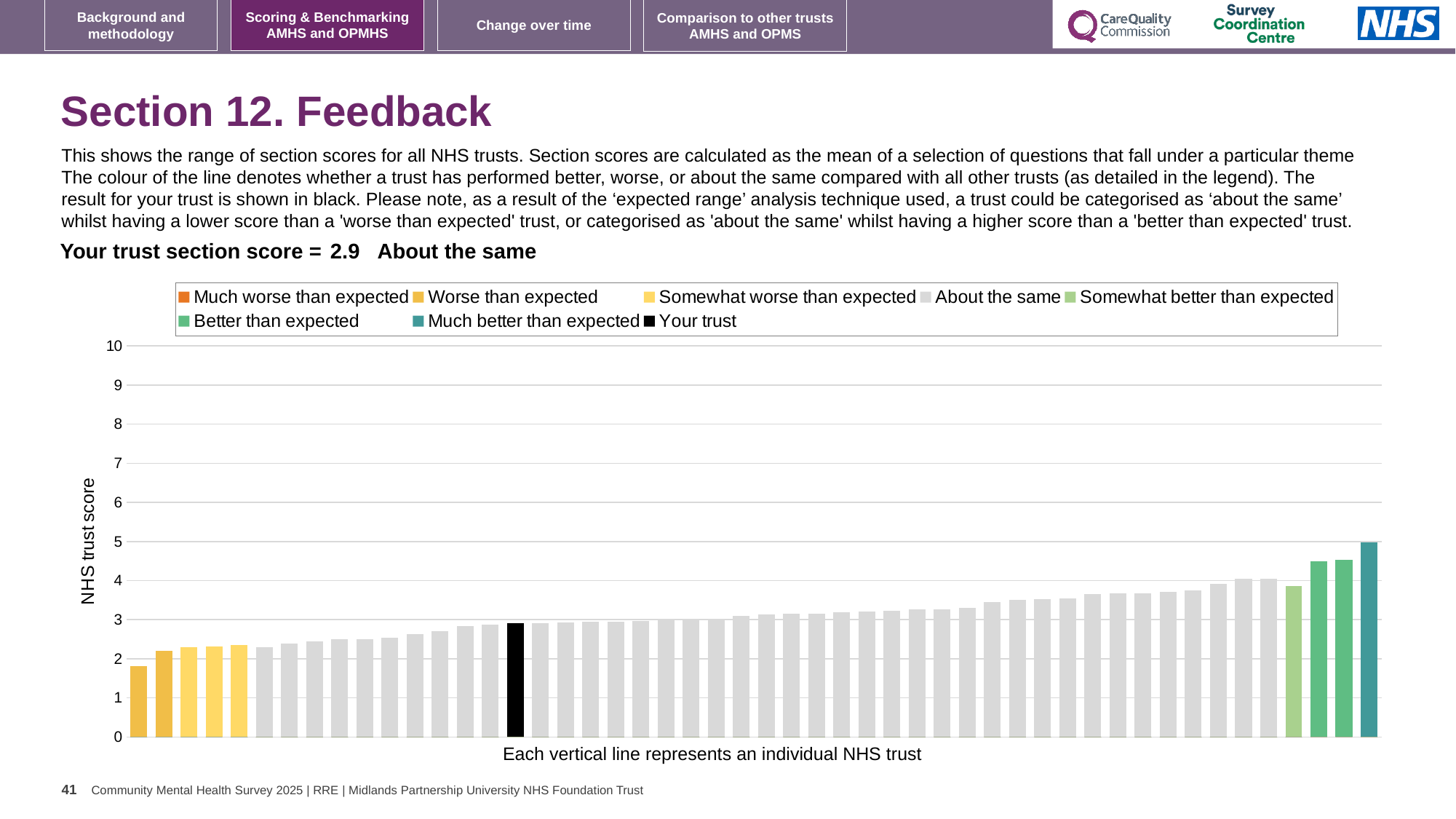
Is the value of the rightmost bar greater or less than 4? greater Do the bar values rise or fall from left to right across the chart? Rise Is the value of the black bar (your trust) greater or less than 3? less What is the highest value shown on the vertical axis? 10 What is the title of the vertical axis? NHS trust score What kind of chart is shown on the slide? Bar chart Is the value of the shortest bar in the chart greater or less than 2? less What colour is the bar representing your trust? Black How many entries does the chart legend list? 8 What is the section score for your trust shown on the slide? 2.9 Which category is your trust placed in for this section? About the same